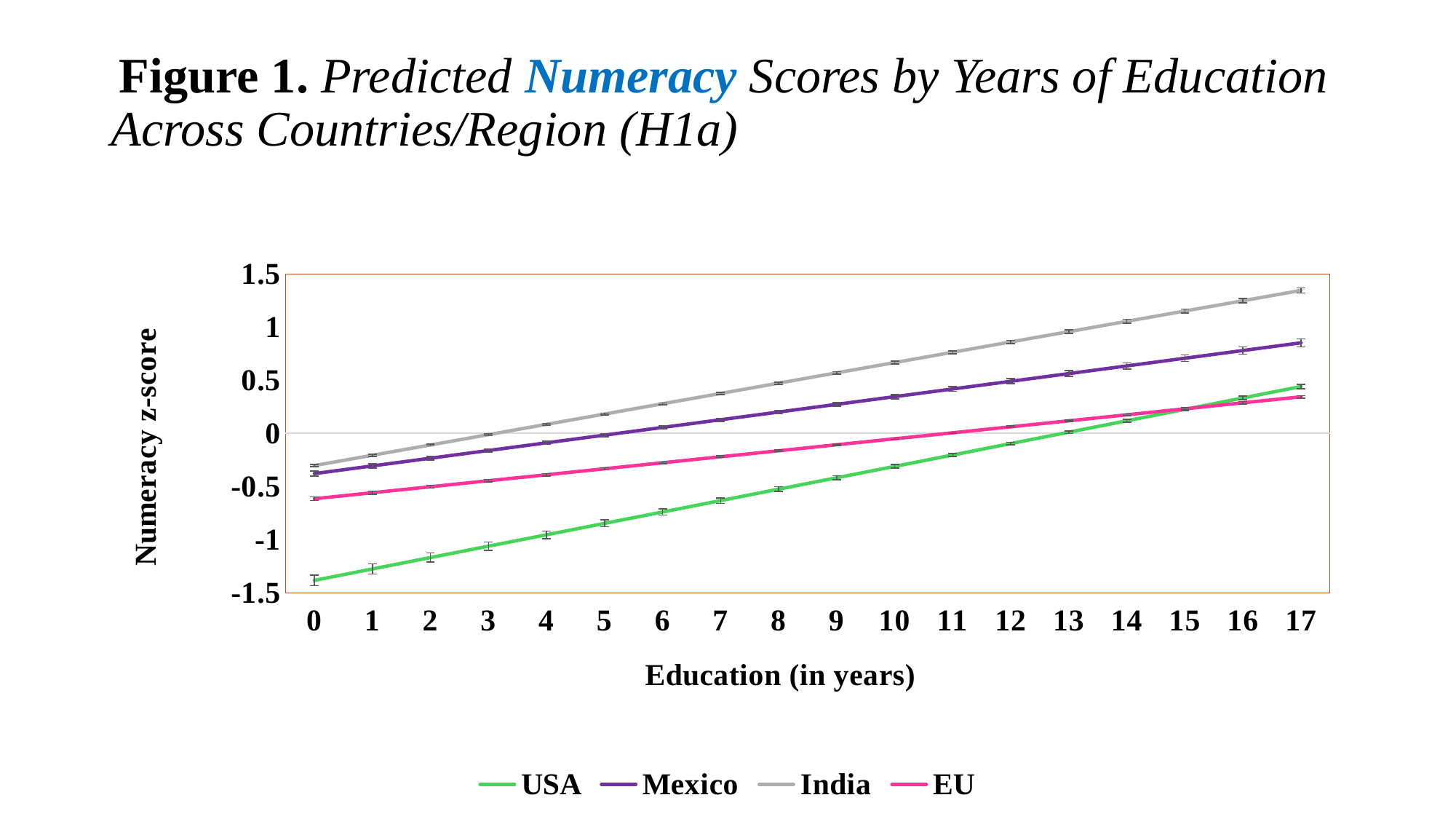
Which country/region has the lowest predicted numeracy z-score at 0 years of education? USA What kind of chart is shown on the slide? line chart Is the predicted numeracy z-score for India at 17 years of education greater or less than 1? greater Is the predicted numeracy z-score for USA at 0 years of education greater or less than -1? less How many years of education values are shown along the x axis? 18 What is the label of the x axis? Education (in years) Is the predicted numeracy z-score for Mexico at 17 years of education greater or less than 0.5? greater How many series does the legend list? 4 What is the label of the y axis? Numeracy z-score At 17 years of education, which has the larger predicted numeracy z-score, Mexico or EU? Mexico Do the predicted numeracy z-scores rise or fall as years of education increase? rise Which country/region has the highest predicted numeracy z-score at 17 years of education? India